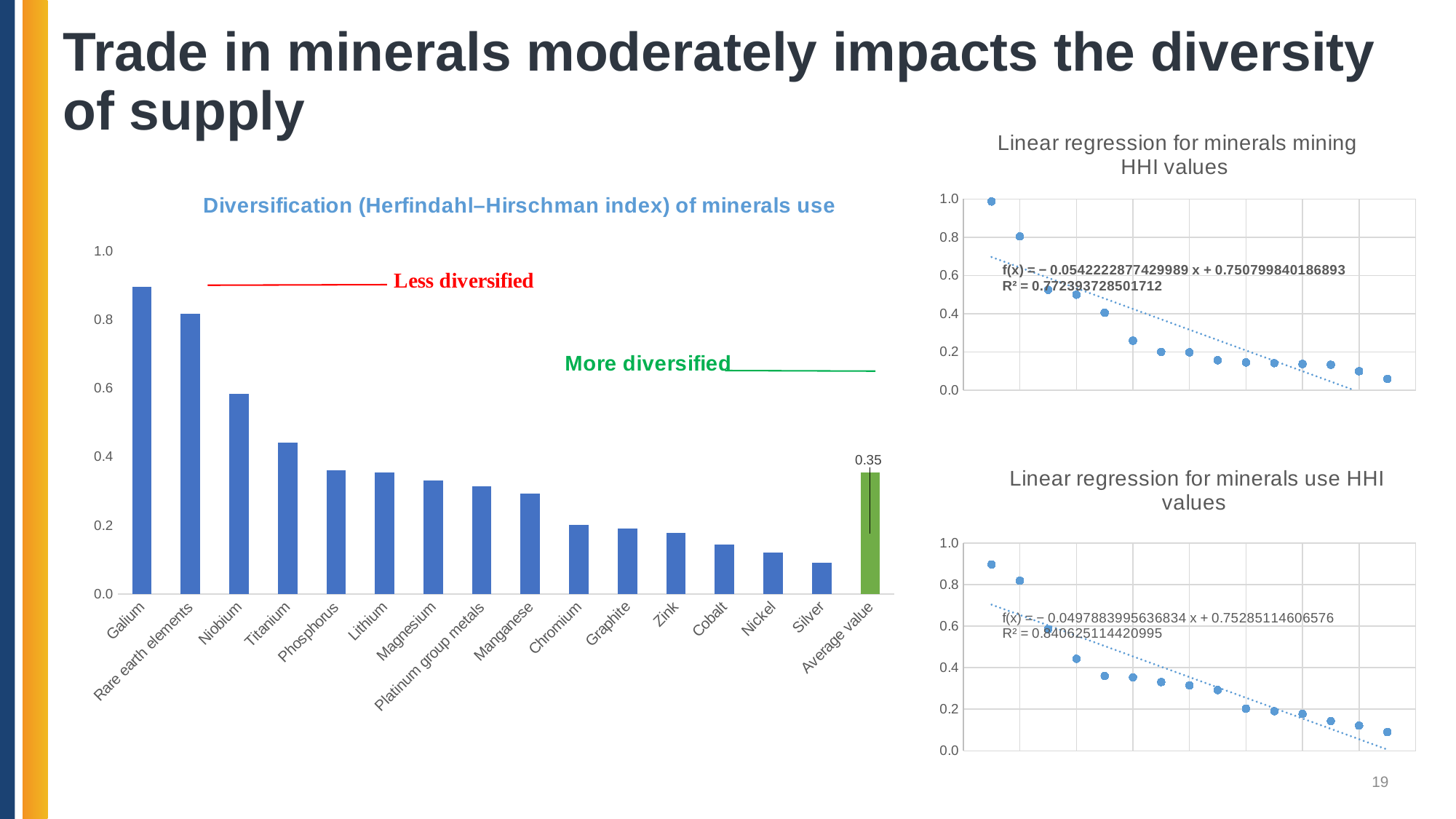
What kind of chart is the 'Diversification (Herfindahl–Hirschman index) of minerals use' chart? bar chart How many categories are shown on the x axis of the 'Diversification (Herfindahl–Hirschman index) of minerals use' chart? 16 In the 'Diversification (Herfindahl–Hirschman index) of minerals use' chart, which mineral has the highest value? Galium What R² value is printed on the 'Linear regression for minerals use HHI values' chart? 0.840625114420995 In the 'Diversification (Herfindahl–Hirschman index) of minerals use' chart, is the value for Galium greater or less than 0.8? greater In the 'Diversification (Herfindahl–Hirschman index) of minerals use' chart, is the value for Chromium greater or less than 0.4? less In the 'Diversification (Herfindahl–Hirschman index) of minerals use' chart, which is larger, the value for Niobium or for Titanium? Niobium In the 'Diversification (Herfindahl–Hirschman index) of minerals use' chart, what is the value labelled for 'Average value'? 0.35 What kind of chart is the 'Linear regression for minerals mining HHI values' chart? scatter chart In the 'Diversification (Herfindahl–Hirschman index) of minerals use' chart, which is larger, the value for Galium or for Rare earth elements? Galium In the 'Diversification (Herfindahl–Hirschman index) of minerals use' chart, which category has the lowest bar? Silver In the 'Diversification (Herfindahl–Hirschman index) of minerals use' chart, do the mineral values rise or fall from Galium to Silver along the x axis? fall